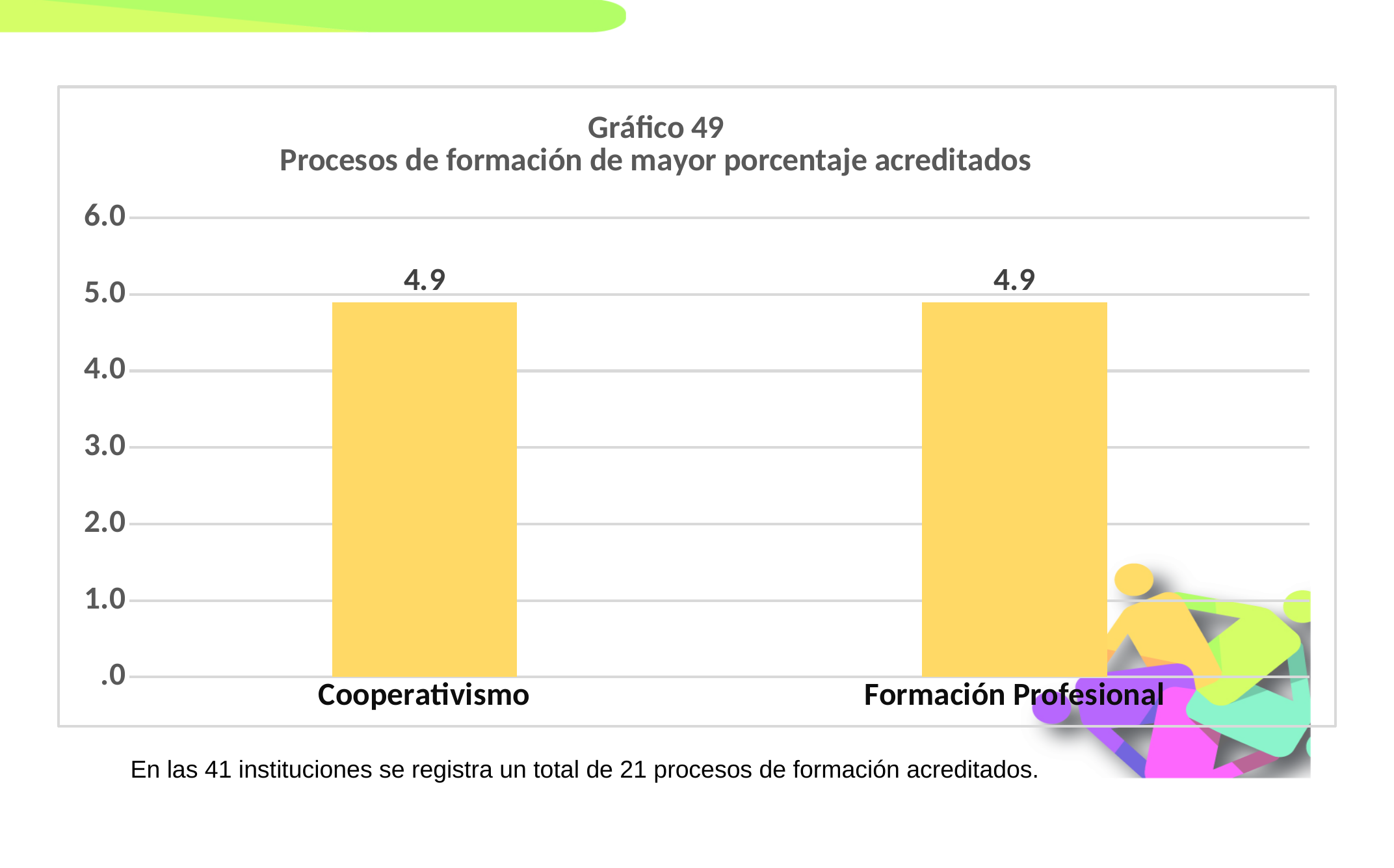
Is the value for Formación Profesional greater or less than 5.0? less What is the title of the chart? Gráfico 49 Procesos de formación de mayor porcentaje acreditados Is the value for Cooperativismo greater or less than 4.0? greater What colour are the bars in the chart? yellow What kind of chart is shown on the slide? bar chart What is the value for Formación Profesional? 4.9 What is the difference between the values for Cooperativismo and Formación Profesional? 0.0 What is the highest value shown on the vertical axis? 6.0 What is the value for Cooperativismo? 4.9 How many categories are shown in the chart? 2